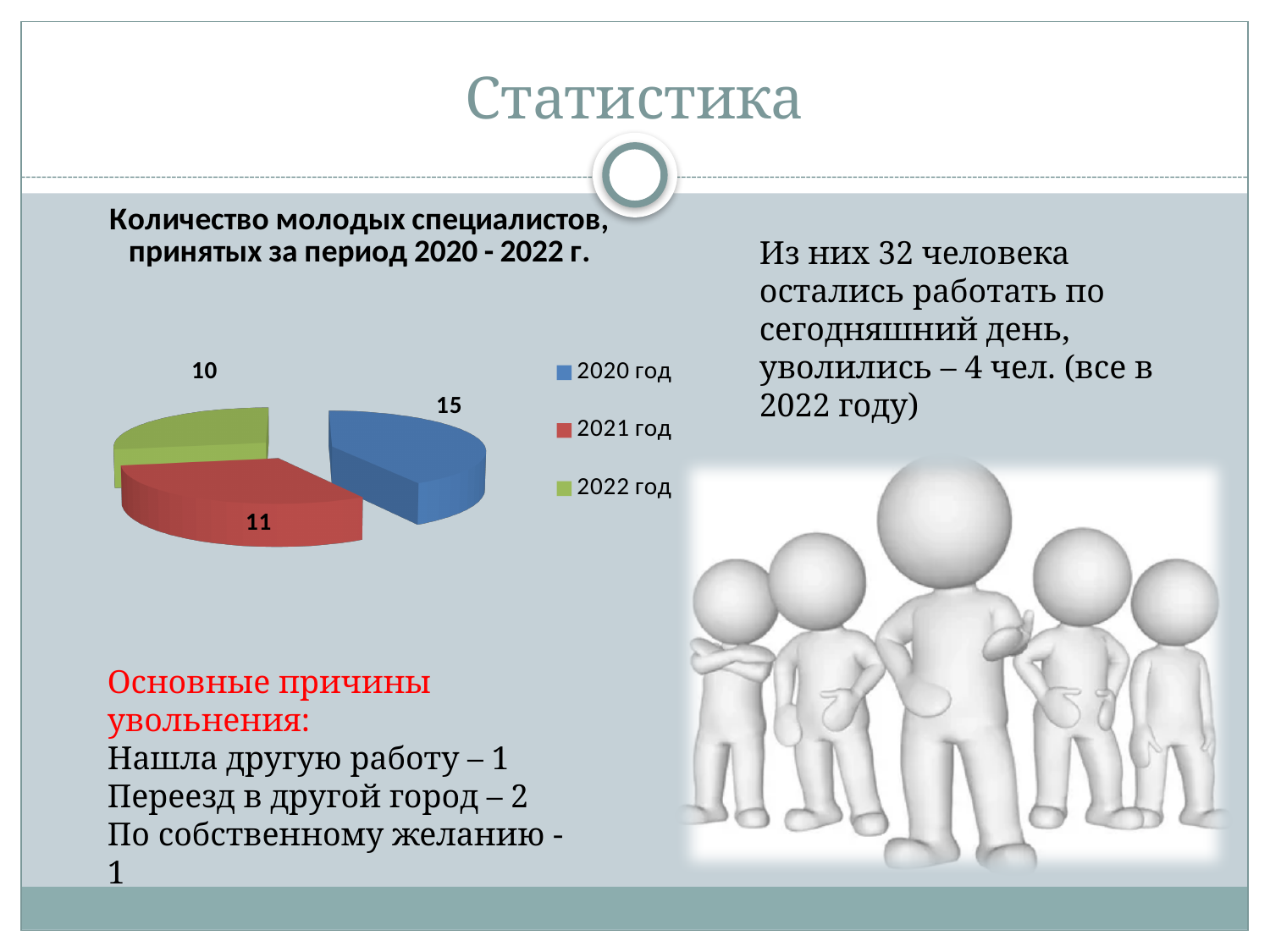
What colour is the slice for 2021 год in the pie chart? Red How many entries does the legend of the pie chart list? 3 What is the value for 2022 год in the pie chart? 10 What is the title of the pie chart? Количество молодых специалистов, принятых за период 2020 - 2022 г. What is the value for 2020 год in the pie chart? 15 What is the difference between the values for 2020 год and 2022 год? 5 Which year has the largest slice in the pie chart? 2020 год What type of chart is shown on the slide? Pie chart How many slices does the pie chart have? 3 Which year has the smallest slice in the pie chart? 2022 год Which is larger, the value for 2021 год or the value for 2022 год? 2021 год What is the value for 2021 год in the pie chart? 11